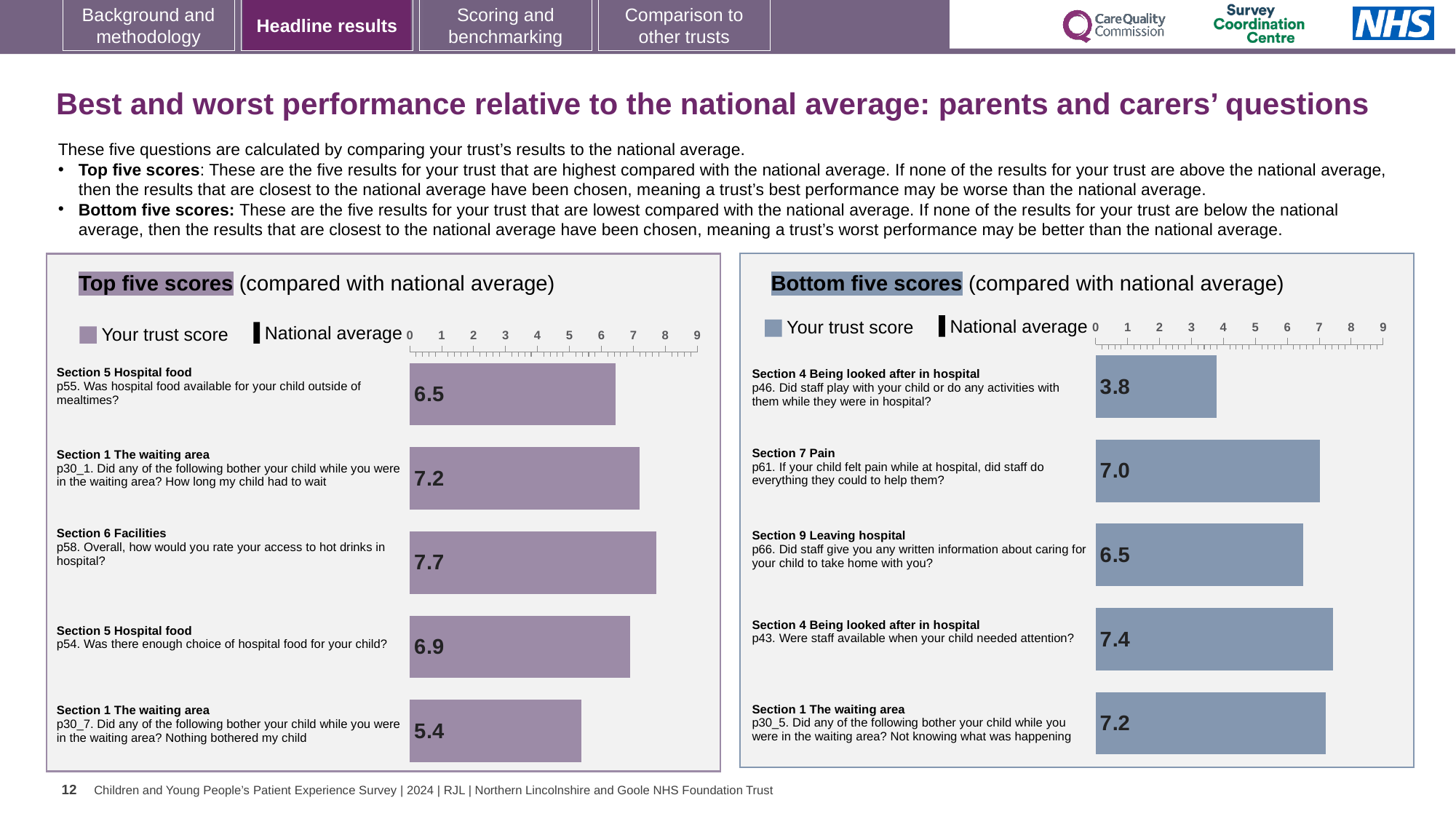
In the 'Bottom five scores' chart, which has the larger trust score: p61 (Pain) or p66 (Leaving hospital)? p61 (Pain) What type of chart is the 'Bottom five scores' chart? Bar chart In the 'Top five scores' chart, what is the difference between the trust scores for p30_1 (7.2) and p55 (6.5)? 0.7 In the 'Top five scores' chart, what is the trust score for p58 (access to hot drinks in hospital)? 7.7 In the 'Bottom five scores' chart, which question has the lowest trust score? p46. Did staff play with your child or do any activities with them while they were in hospital? In the 'Bottom five scores' chart, what is the difference between the trust scores for p43 and p46? 3.6 In the 'Bottom five scores' chart, what is the trust score for p43 (Were staff available when your child needed attention)? 7.4 In the 'Top five scores' chart, which question has the highest trust score? p58. Overall, how would you rate your access to hot drinks in hospital? In the 'Top five scores' chart, what is the trust score for p30_7 (Nothing bothered my child in the waiting area)? 5.4 How many entries does the legend of the 'Top five scores' chart list? 2 How many questions are plotted in the 'Top five scores' chart? 5 In the 'Bottom five scores' chart, what is the trust score for p46 (Did staff play with your child or do any activities)? 3.8